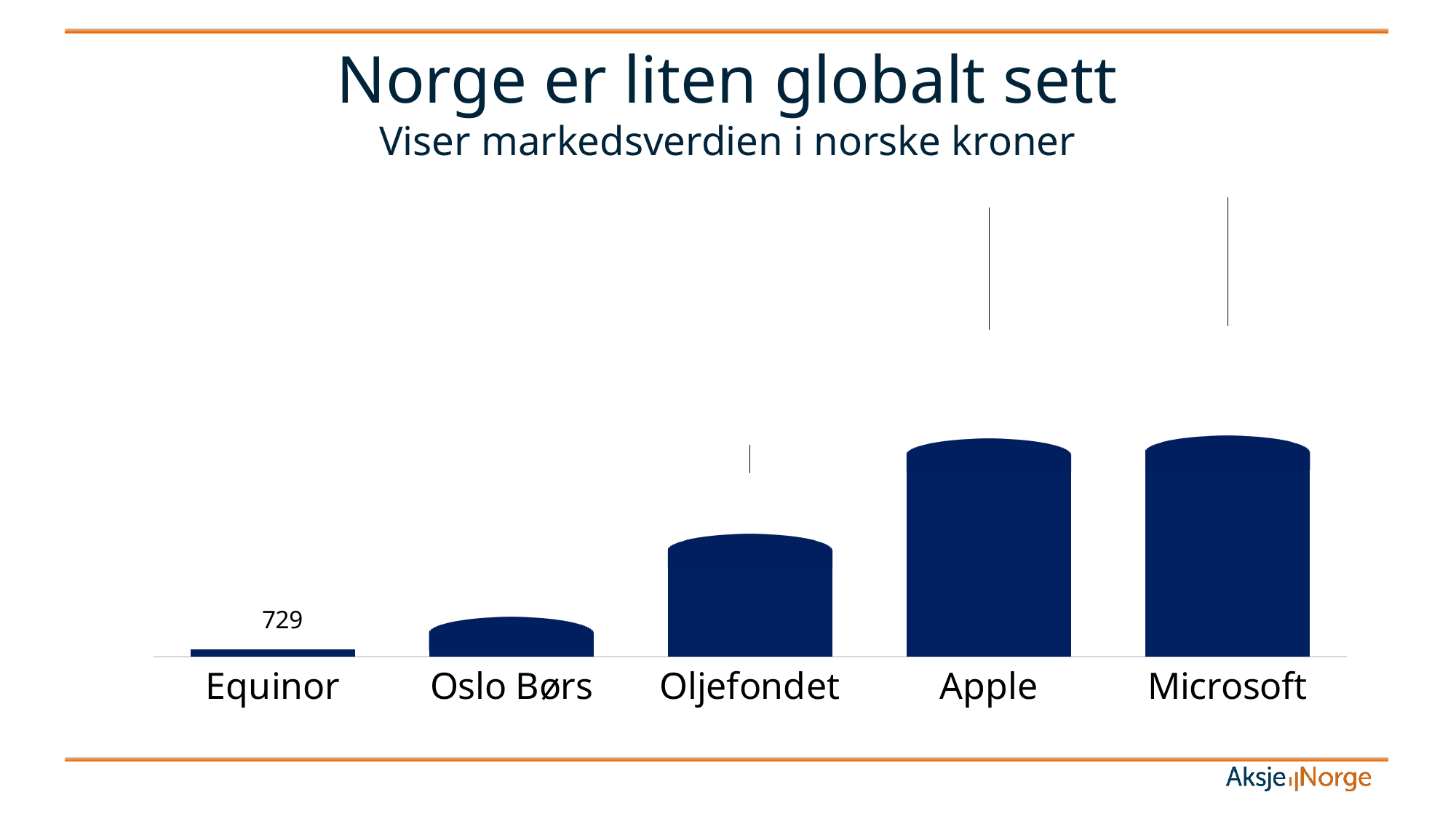
Which category is plotted furthest to the right on the x axis? Microsoft Which is larger, the bar for Oljefondet or the bar for Apple? Apple How many categories are shown on the x axis? 5 What is the main title of the slide? Norge er liten globalt sett Which is larger, the bar for Equinor or the bar for Oslo Børs? Oslo Børs What is the value shown for Equinor? 729 Which category has the lowest bar? Equinor What kind of chart is shown on the slide? Bar chart Do the bar values generally rise or fall from left to right along the x axis? Rise Which category is the only one with a printed data label? Equinor Which is larger, the bar for Oslo Børs or the bar for Oljefondet? Oljefondet